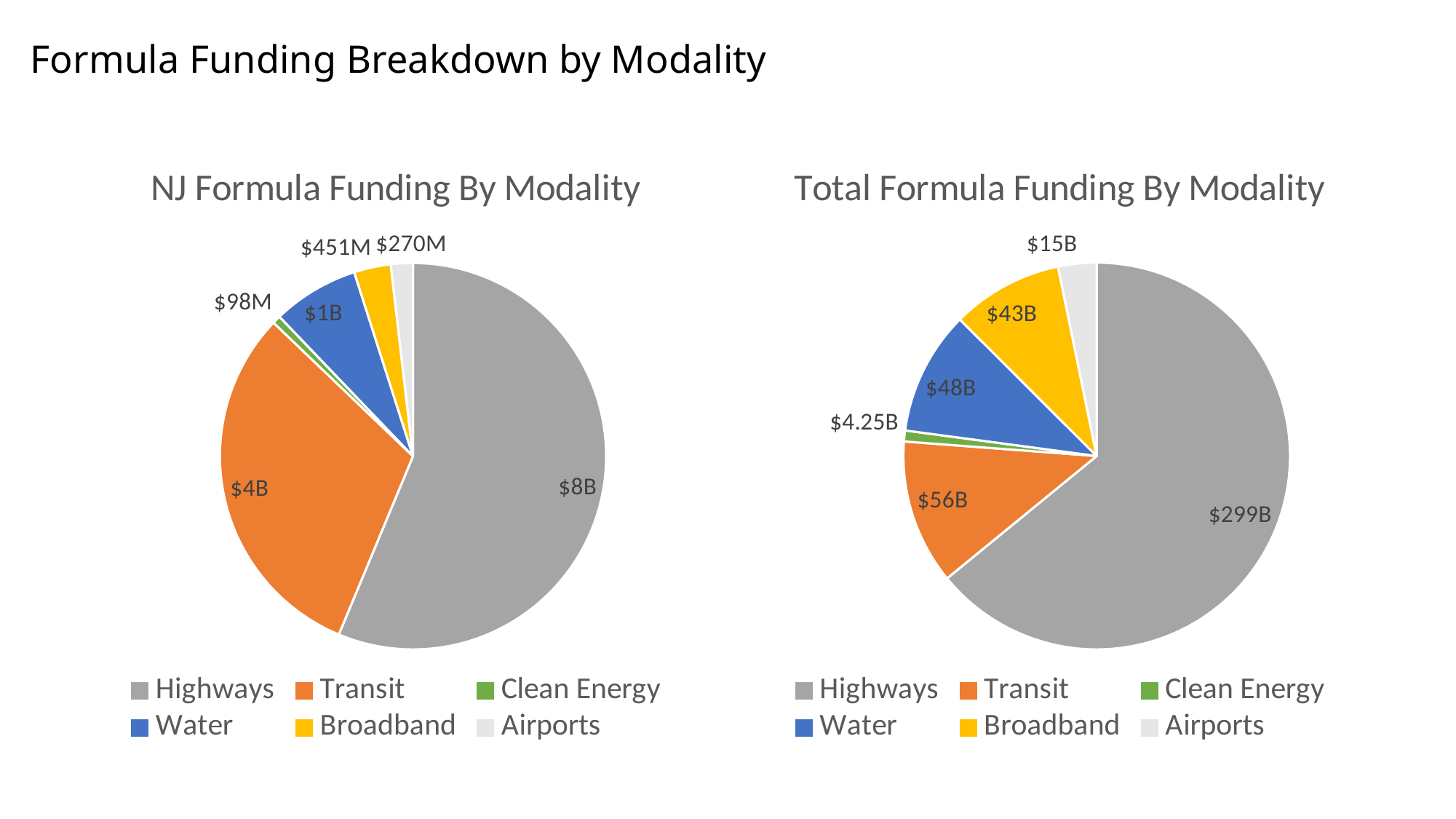
What type of chart is the NJ Formula Funding By Modality chart? Pie chart In the Total Formula Funding By Modality chart, what colour is the Broadband slice? Yellow How many slices does the Total Formula Funding By Modality chart have? 6 In the Total Formula Funding By Modality chart, what is the value for Water? $48B In the NJ Formula Funding By Modality chart, which modality has the smallest slice? Clean Energy In the NJ Formula Funding By Modality chart, which is larger, Water or Broadband? Water In the NJ Formula Funding By Modality chart, what is the value for Clean Energy? $98M In the Total Formula Funding By Modality chart, what is the difference between Highways and Transit? $243B In the NJ Formula Funding By Modality chart, what is the value for Highways? $8B In the Total Formula Funding By Modality chart, what is the value for Airports? $15B In the NJ Formula Funding By Modality chart, what is the value for Broadband? $451M In the Total Formula Funding By Modality chart, which modality has the largest slice? Highways